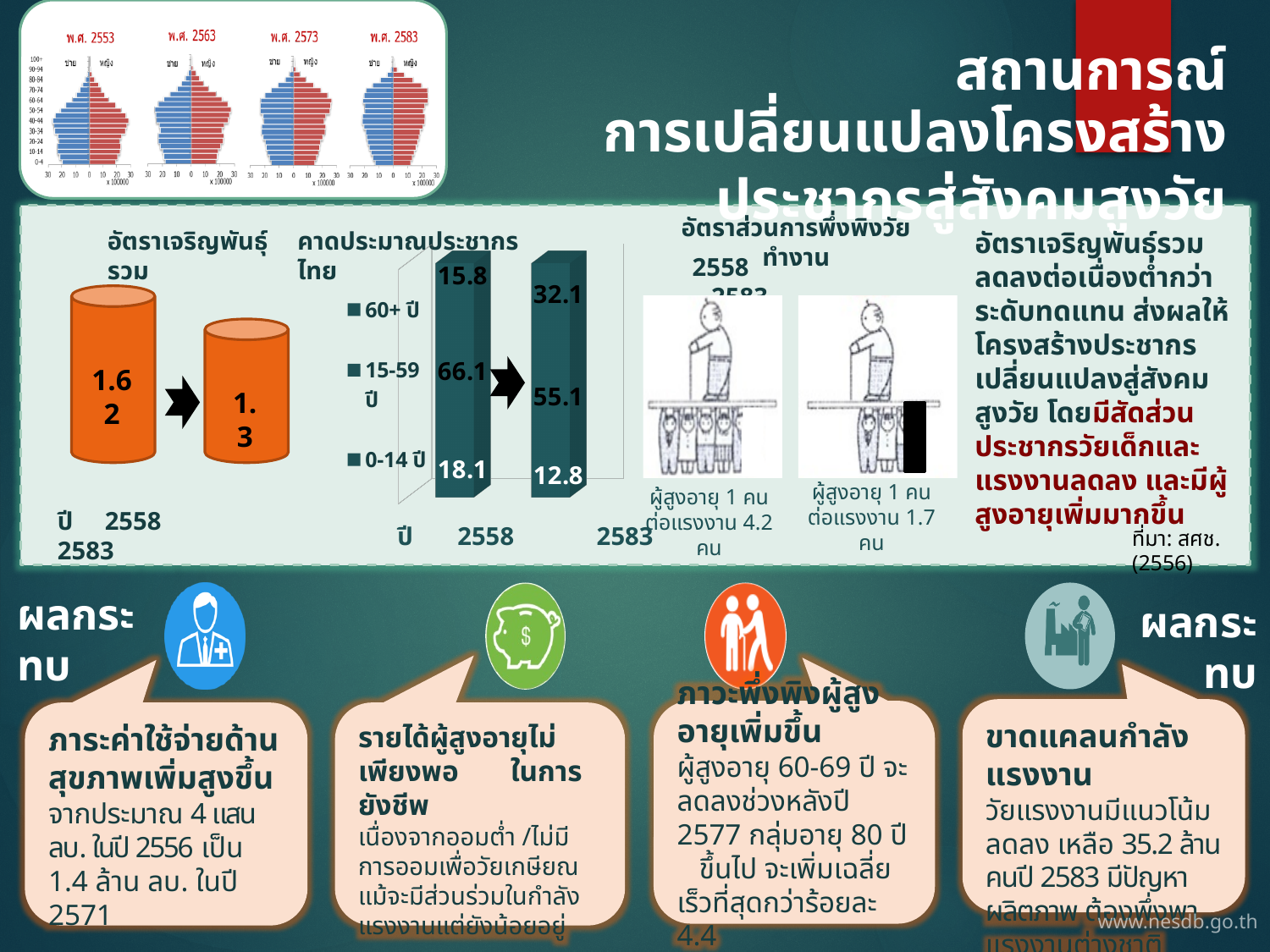
In the stacked bar chart titled คาดประมาณประชากรไทย, what is the value for the 15-59 ปี series in 2583? 55.1 In the stacked bar chart titled คาดประมาณประชากรไทย, is the 15-59 ปี value larger in 2558 or in 2583? 2558 In the stacked bar chart titled คาดประมาณประชากรไทย, by how much does the 60+ ปี value in 2583 exceed the 60+ ปี value in 2558? 16.3 In the stacked bar chart titled คาดประมาณประชากรไทย, what is the value for the 60+ ปี series in 2558? 15.8 In the stacked bar chart titled คาดประมาณประชากรไทย, which series has the largest value in 2558? 15-59 ปี In the stacked bar chart titled คาดประมาณประชากรไทย, which series has the smallest value in 2583? 0-14 ปี In the stacked bar chart titled คาดประมาณประชากรไทย, what is the value for the 0-14 ปี series in 2558? 18.1 In the cylinder chart titled อัตราเจริญพันธุ์รวม on the left, what is the value shown for 2583? 1.3 In the stacked bar chart titled คาดประมาณประชากรไทย, how many bars (years) are plotted? 2 In the stacked bar chart titled คาดประมาณประชากรไทย, does the 60+ ปี value rise or fall from 2558 to 2583? rise In the stacked bar chart titled คาดประมาณประชากรไทย, how many series does the legend list? 3 In the stacked bar chart titled คาดประมาณประชากรไทย, what is the value for the 0-14 ปี series in 2583? 12.8